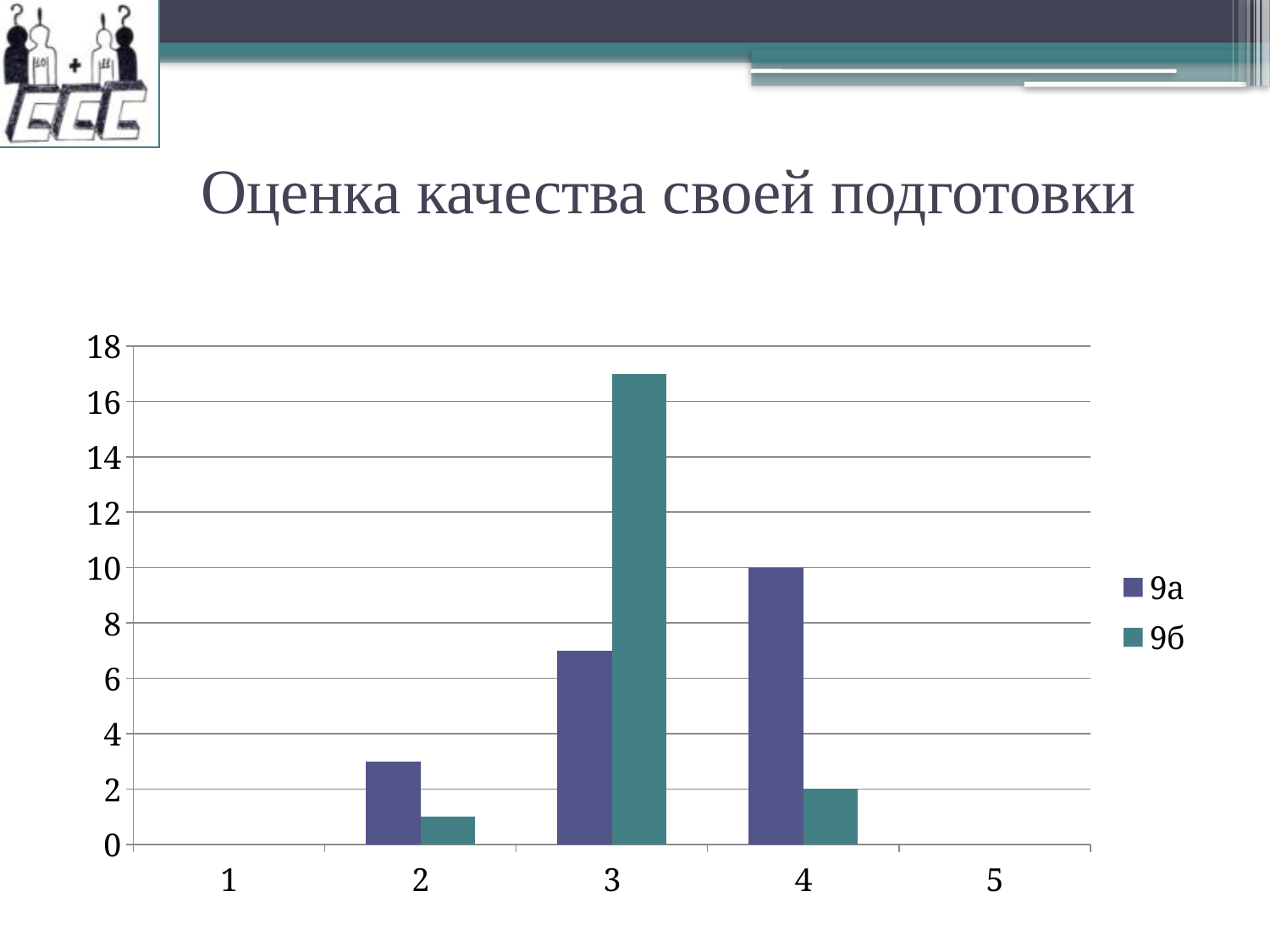
What is the difference between the values of 9а and 9б at category 4? 8 Which category has the highest value for series 9б? 3 At category 3, which series has the larger value, 9а or 9б? 9б Is the value for series 9б at category 3 greater or less than 16? greater What is the value for series 9б at category 4? 2 What is the title of the chart on the slide? Оценка качества своей подготовки Is the value for series 9а at category 3 greater or less than 8? less Which category has the highest value for series 9а? 4 What is the value for series 9а at category 4? 10 What type of chart is shown on the slide? bar chart How many categories are shown on the x axis? 5 How many series does the legend list? 2